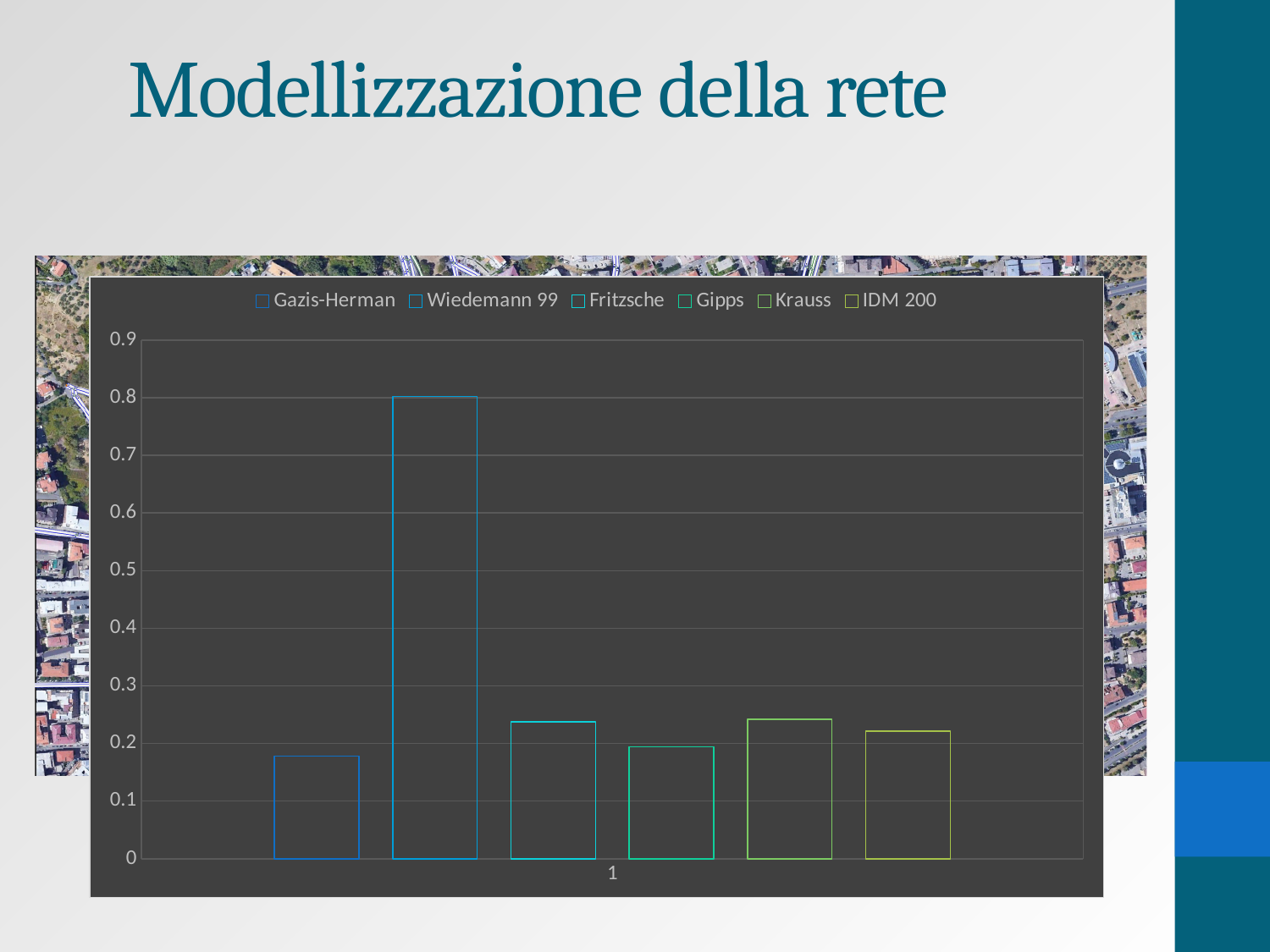
Is the value for Gazis-Herman greater or less than 0.2? less What kind of chart is shown on the slide? bar chart Is the value for Krauss greater or less than 0.3? less What is the first series listed in the chart legend? Gazis-Herman Is the value for IDM 200 greater or less than 0.2? greater How many series does the chart legend list? 6 Which is larger, the value for Krauss or the value for Gazis-Herman? Krauss Which is larger, the value for Wiedemann 99 or the value for Gipps? Wiedemann 99 Which series has the highest bar in the chart? Wiedemann 99